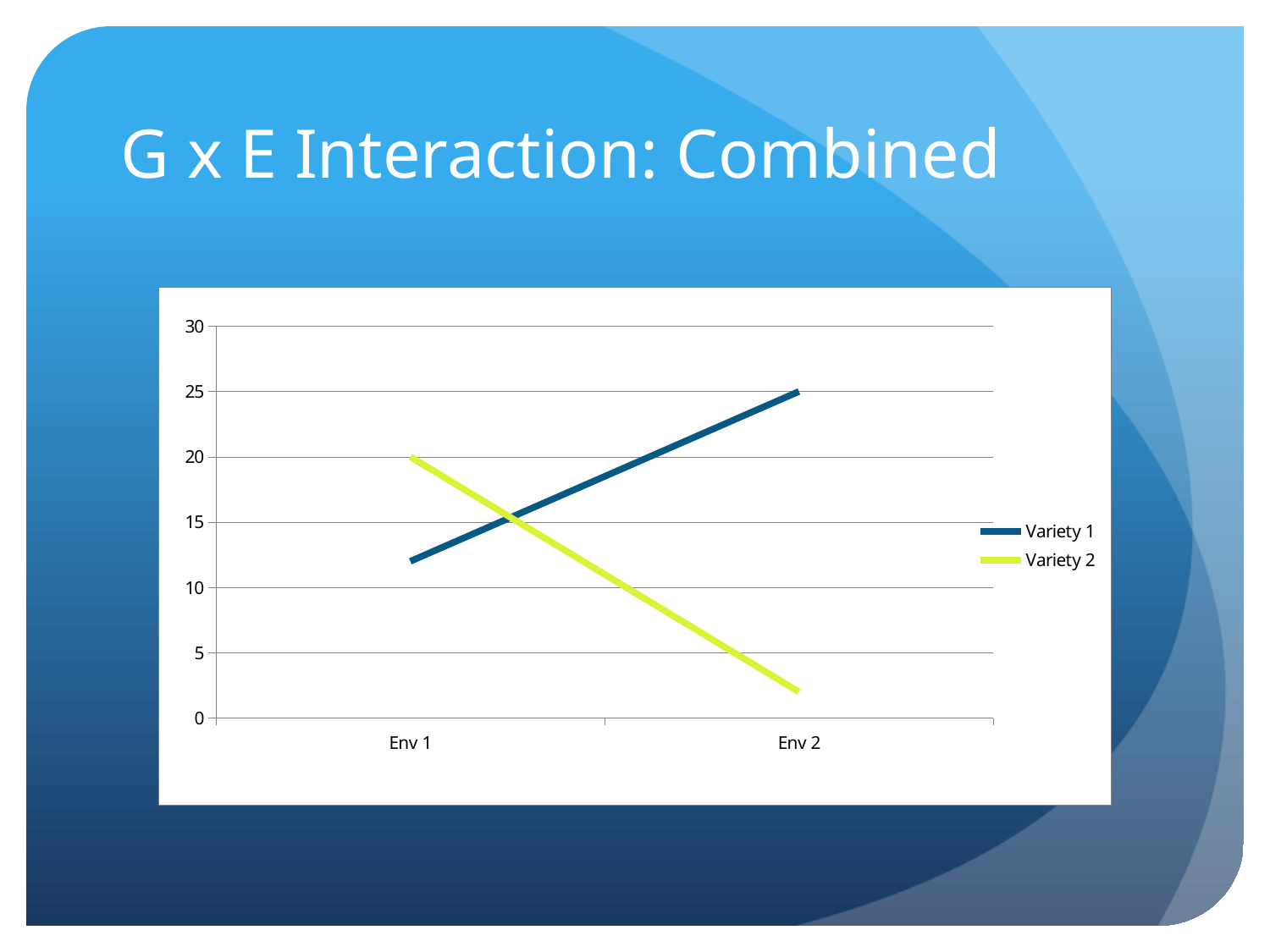
How many series does the legend list? 2 How much higher is Variety 1's value at Env 2 than Variety 2's value at Env 1? 5 Does the Variety 2 line rise or fall from Env 1 to Env 2? Fall Does the Variety 1 line rise or fall from Env 1 to Env 2? Rise At Env 2, which variety has the higher value? Variety 1 Is the value for Variety 2 at Env 2 greater or less than 5? less What is the value for Variety 2 at Env 1? 20 How many environments (categories) are shown on the x axis? 2 Is the value for Variety 1 at Env 1 greater or less than 10? greater What is the title of the slide containing the chart? G x E Interaction: Combined What is the value for Variety 1 at Env 2? 25 What kind of chart is shown on the slide? Line chart